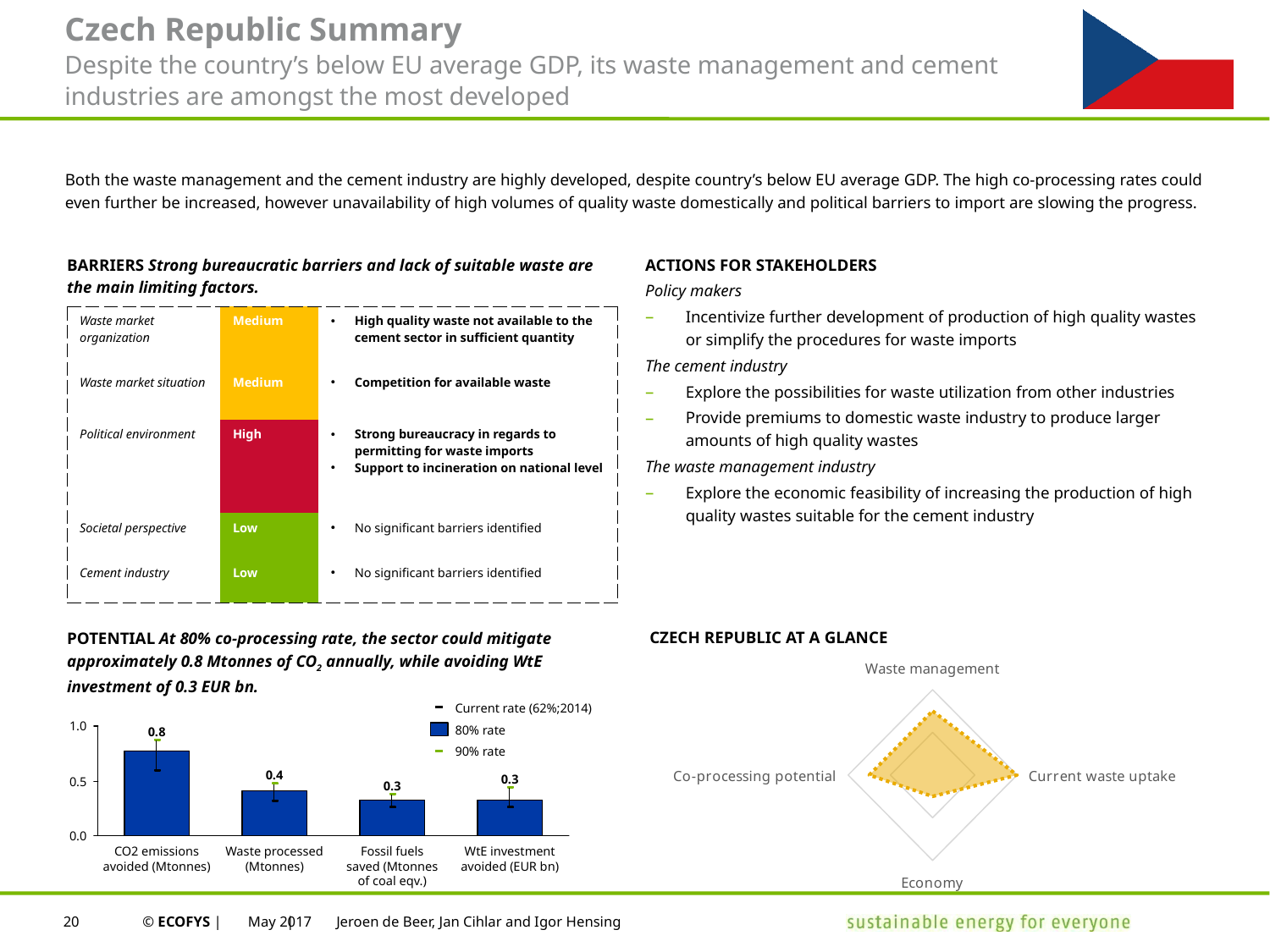
How many categories are shown on the x axis of the bar chart at the bottom left? 4 In the bar chart at the bottom left, what is the difference between the values for CO2 emissions avoided and Waste processed? 0.4 What is the title of the radar chart at the bottom right of the slide? CZECH REPUBLIC AT A GLANCE In the bar chart at the bottom left, what is the value for CO2 emissions avoided (Mtonnes)? 0.8 In the bar chart at the bottom left, which is larger: the value for Waste processed or the value for Fossil fuels saved? Waste processed In the bar chart at the bottom left, which category has the highest value? CO2 emissions avoided (Mtonnes) In the bar chart at the bottom left, what is the value for WtE investment avoided (EUR bn)? 0.3 In the bar chart at the bottom left, what is the value for Waste processed (Mtonnes)? 0.4 How many entries does the legend of the bar chart at the bottom left list? 3 What kind of chart is shown at the bottom left of the slide? Bar chart In the bar chart at the bottom left, what does the legend say the current rate is? 62%;2014 In the bar chart at the bottom left, is the value for CO2 emissions avoided greater or less than 0.5? greater